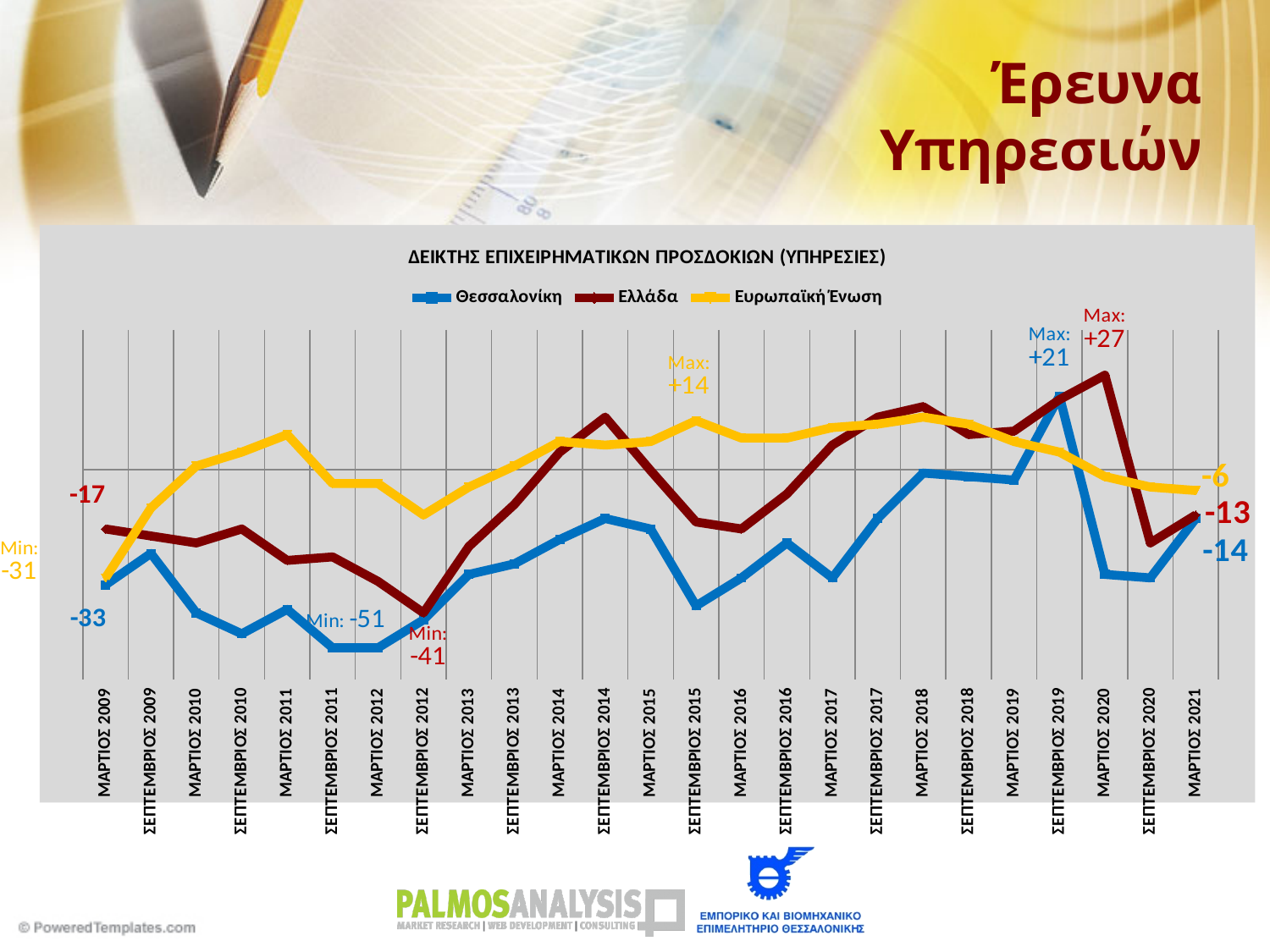
What type of chart is shown on the slide? line chart How many time points are shown on the x axis? 25 What is the maximum value reached by the Ευρωπαϊκή Ένωση series? +14 What is the value for Ελλάδα in ΜΑΡΤΙΟΣ 2021? -13 What is the value for Ελλάδα in ΜΑΡΤΙΟΣ 2009? -17 In ΜΑΡΤΙΟΣ 2009, how much higher is the Ελλάδα value than the Θεσσαλονίκη value? 16 What is the maximum value reached by the Ελλάδα series? +27 What is the minimum value reached by the Θεσσαλονίκη series? -51 What is the value for Ευρωπαϊκή Ένωση in ΜΑΡΤΙΟΣ 2021? -6 In ΜΑΡΤΙΟΣ 2021, which series has the higher value, Ελλάδα or Θεσσαλονίκη? Ελλάδα What is the value for Θεσσαλονίκη in ΜΑΡΤΙΟΣ 2009? -33 How many series does the legend list? 3